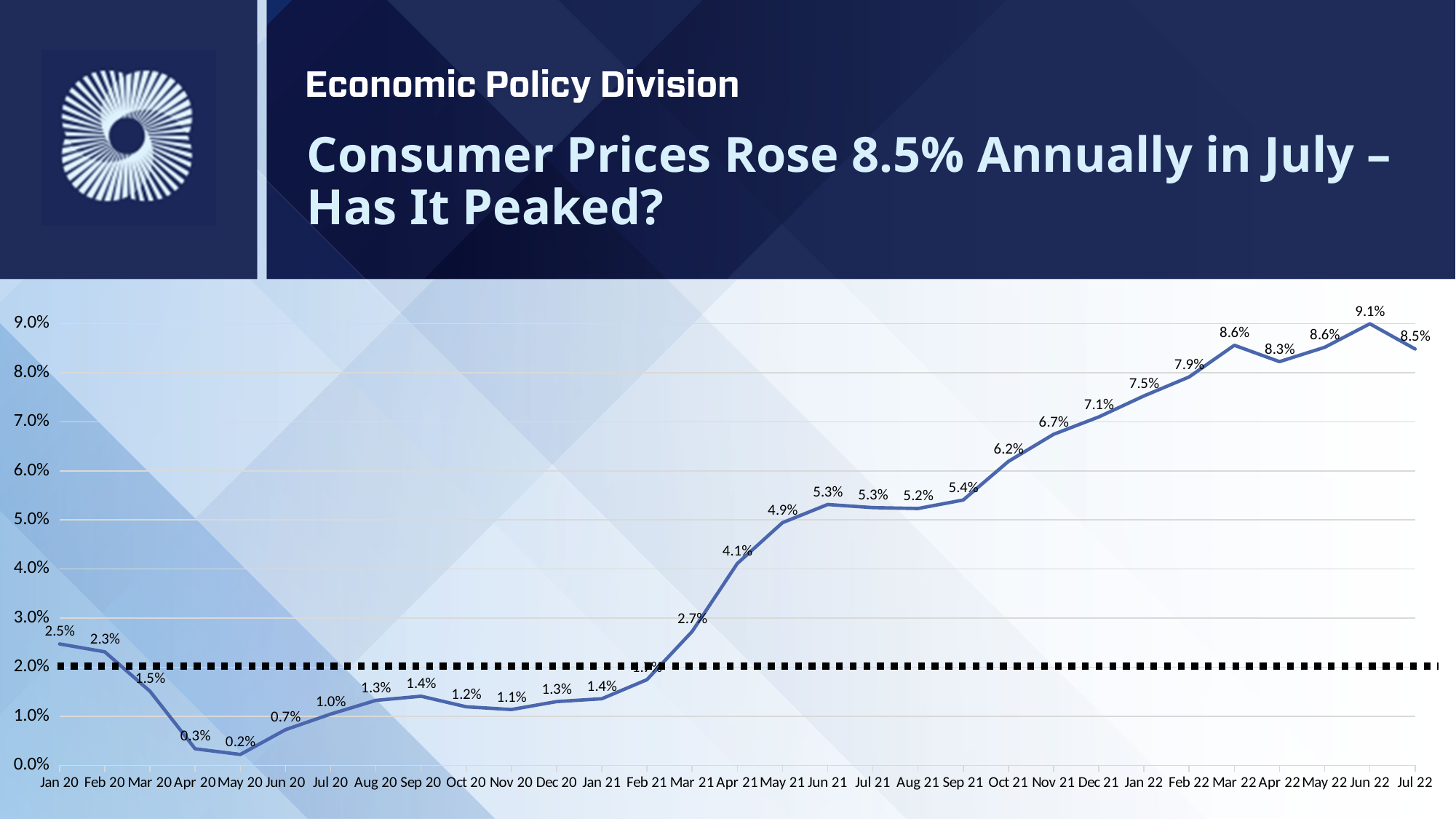
What kind of chart is shown on the slide? line chart What is the value for Jul 22? 8.5% At what level is the horizontal dotted reference line drawn? 2.0% What is the difference between the values for Jun 22 and Jul 22? 0.6% What is the value for May 20? 0.2% Which is larger, the value for Mar 22 or the value for Apr 22? Mar 22 What is the value for Jun 22? 9.1% How many months are plotted on the x axis? 31 Is the value for Oct 21 greater or less than 6.0%? greater What is the value for Apr 21? 4.1% Which month has the lowest value? May 20 Which month has the highest value? Jun 22